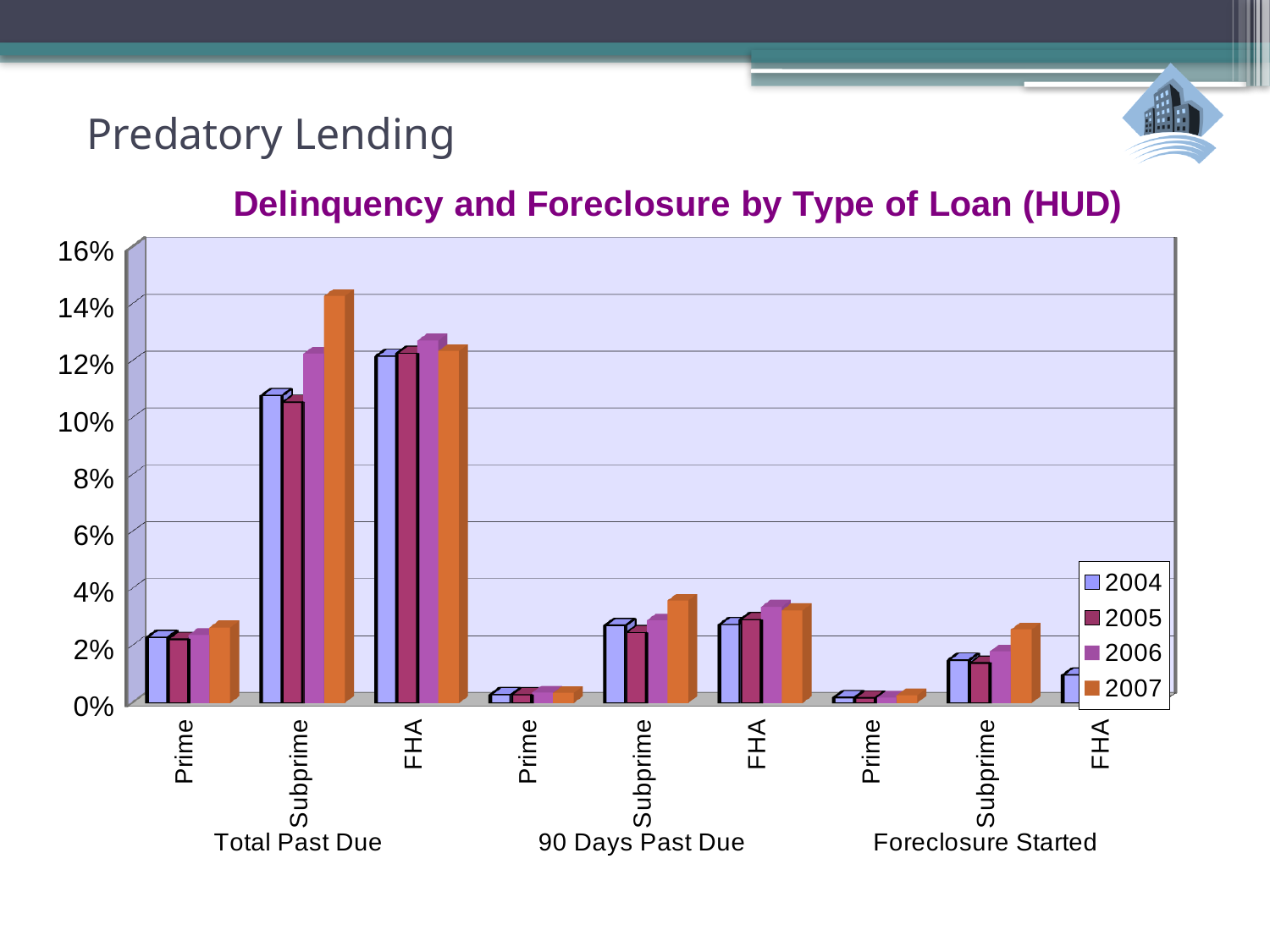
What kind of chart is shown on the slide? bar chart Is the 2007 Total Past Due value for Prime loans greater or less than 4%? less How many series does the legend list? 4 Is the 2007 Total Past Due value for Subprime loans greater or less than 12%? greater In 2004, which has the larger Total Past Due value, Subprime or FHA? FHA Which loan type has the lowest 90 Days Past Due values across all years? Prime Is the 2004 Total Past Due value for FHA loans greater or less than 10%? greater What is the title of the chart? Delinquency and Foreclosure by Type of Loan (HUD) In 2007, which has the larger Total Past Due value, Subprime or FHA? Subprime How many main category groups (such as Total Past Due) are shown along the x axis? 3 Which year has the highest Total Past Due value for Subprime loans? 2007